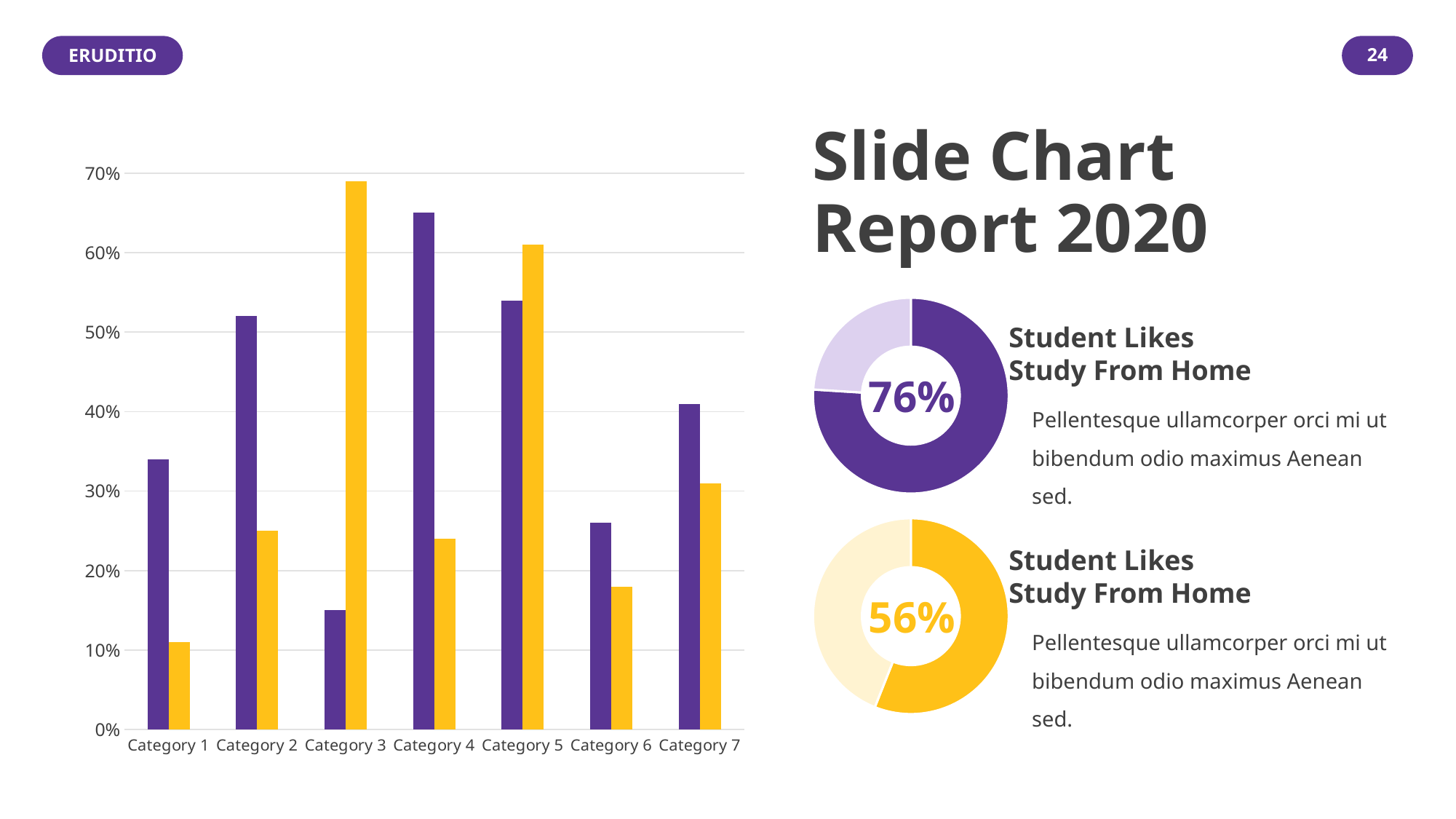
In the bar chart on the left, is the yellow bar for Category 6 greater or less than 20%? less How many categories does the bar chart on the left show? 7 What kind of chart is the large chart on the left of the slide? bar chart In the bar chart on the left, which category has the shortest purple bar? Category 3 What percentage is shown in the centre of the upper (purple) donut chart? 76% What percentage is shown in the centre of the lower (yellow) donut chart? 56% In the bar chart on the left, which category has the tallest yellow bar? Category 3 In the bar chart on the left, is the purple bar for Category 2 greater or less than 50%? greater In the bar chart on the left, which category has the shortest yellow bar? Category 1 In the bar chart on the left, which is larger for Category 7, the purple bar or the yellow bar? the purple bar In the bar chart on the left, which category has the tallest purple bar? Category 4 In the bar chart on the left, which is larger for Category 5, the purple bar or the yellow bar? the yellow bar